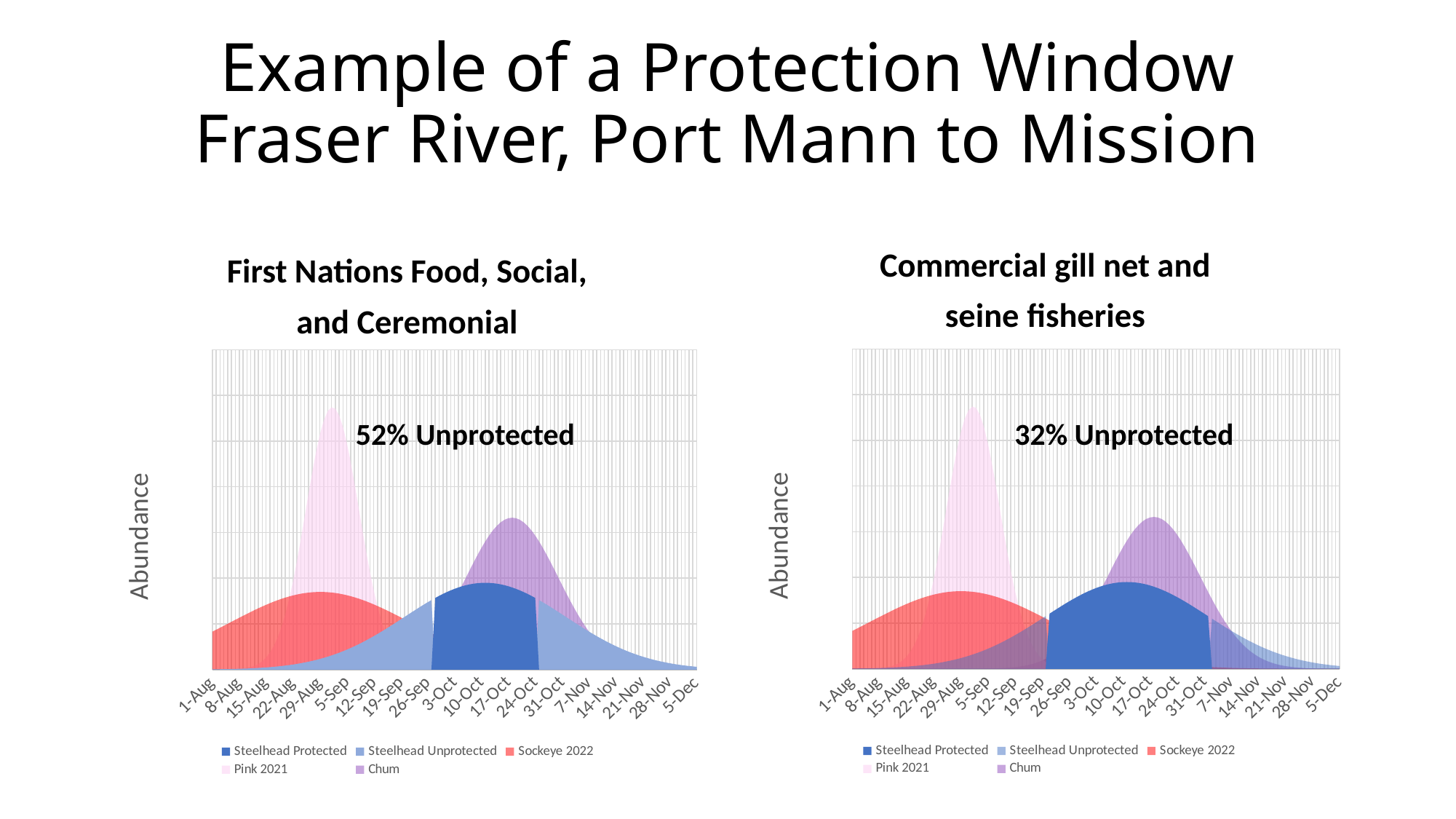
On the 'Commercial gill net and seine fisheries' chart, what percentage is labelled as Unprotected? 32% Unprotected On the 'Commercial gill net and seine fisheries' chart, which series reaches the highest peak? Pink 2021 What is the difference in percentage points between the Unprotected values on the left chart (52%) and the right chart (32%)? 20 percentage points What is the first date label on the x-axis of the 'Commercial gill net and seine fisheries' chart? 1-Aug On the 'First Nations Food, Social, and Ceremonial' chart, what percentage is labelled as Unprotected? 52% Unprotected Which chart shows the higher Unprotected percentage, 'First Nations Food, Social, and Ceremonial' or 'Commercial gill net and seine fisheries'? First Nations Food, Social, and Ceremonial On the 'First Nations Food, Social, and Ceremonial' chart, which series reaches the highest peak? Pink 2021 What is the y-axis label on the 'Commercial gill net and seine fisheries' chart? Abundance On the 'First Nations Food, Social, and Ceremonial' chart, does the Pink 2021 series rise or fall between 5-Sep and 26-Sep? Fall How many series does the legend of the 'Commercial gill net and seine fisheries' chart list? 5 How many date ticks are shown on the x-axis of the 'First Nations Food, Social, and Ceremonial' chart? 19 What kind of chart is the 'First Nations Food, Social, and Ceremonial' chart? Area chart